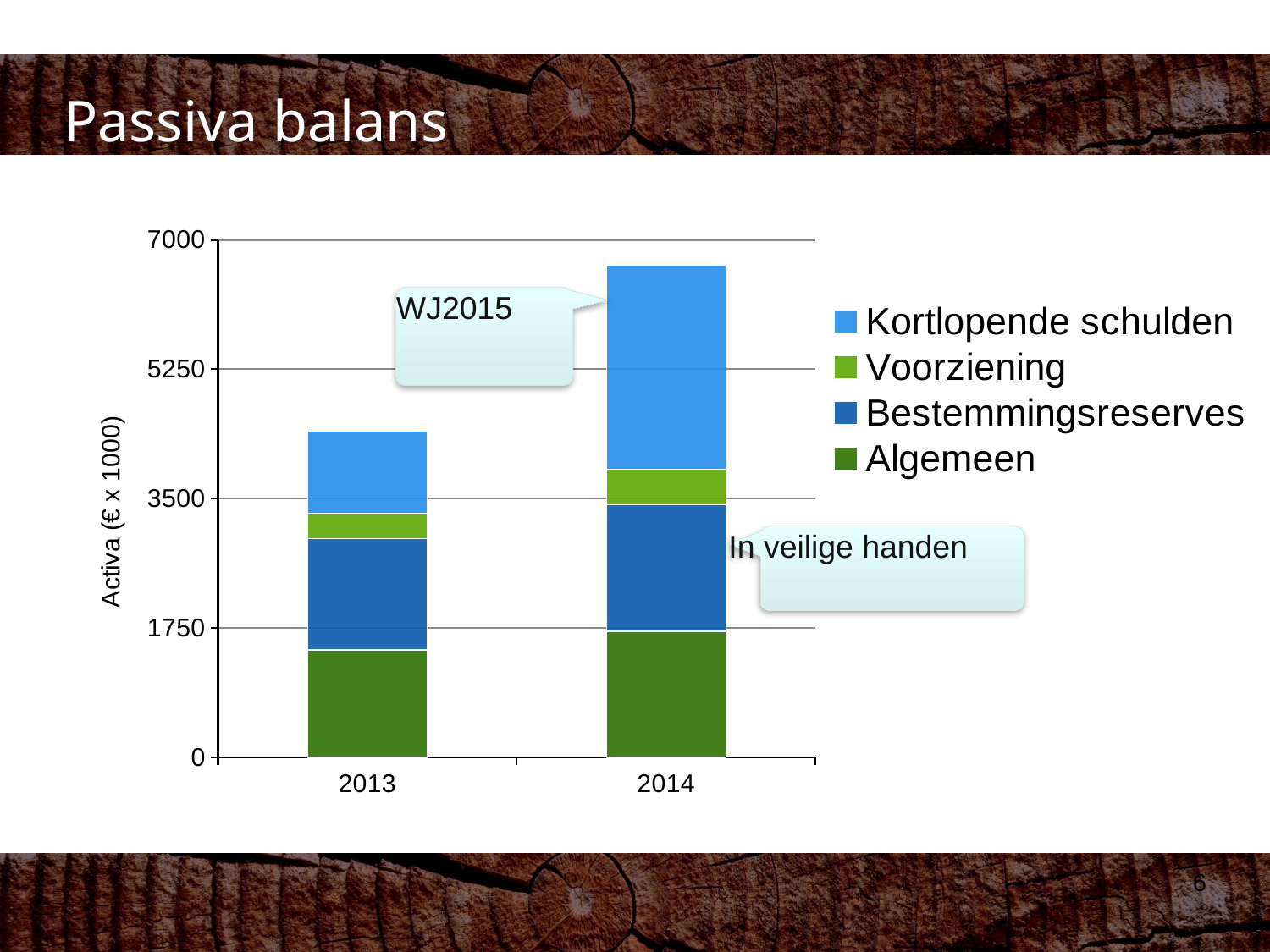
What kind of chart is shown on the slide? Stacked bar chart How many categories are shown on the x axis of the chart? 2 Is the total of the 2014 bar greater or less than 5250? greater Which year has the taller stacked bar, 2013 or 2014? 2014 How many series does the chart's legend list? 4 What is the label on the vertical axis of the chart? Activa (€ x 1000) Is the total of the 2013 bar greater or less than 5250? less Is the total of the 2014 bar greater or less than 7000? less Which legend entry is shown in light blue? Kortlopende schulden Do the total bar heights rise or fall from 2013 to 2014? Rise